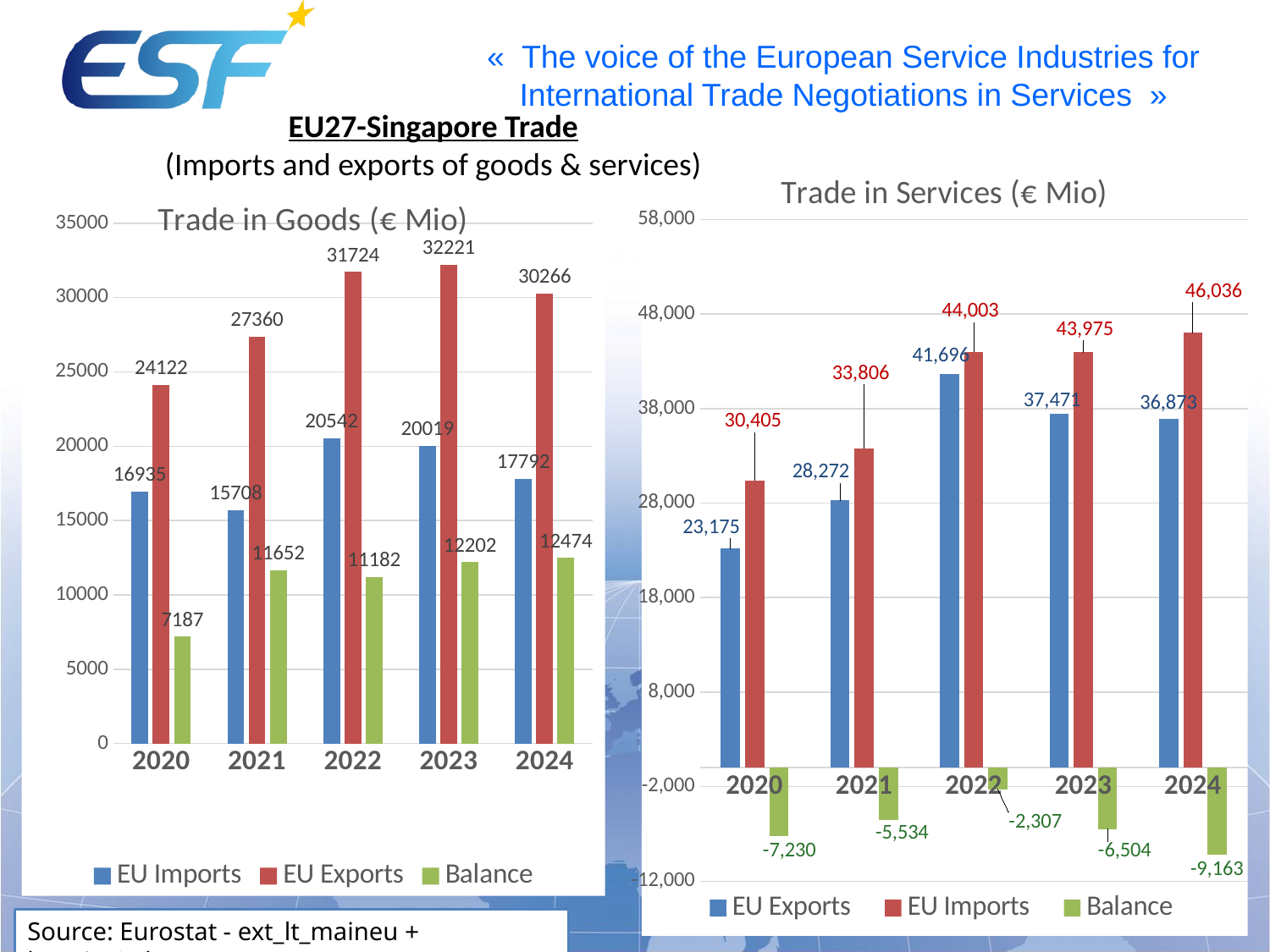
In the Trade in Services chart, what is the value of EU Imports in 2024? 46,036 How many series does the legend of the Trade in Services chart list? 3 In the Trade in Services chart, which year has the lowest Balance value? 2024 What type of chart is the Trade in Goods chart? bar chart In the Trade in Goods chart, which year has the lowest EU Exports value? 2020 In the Trade in Services chart, which year has the highest EU Exports value? 2022 In the Trade in Services chart, is EU Exports in 2021 larger or smaller than EU Imports in 2021? smaller In the Trade in Goods chart, which year has the highest EU Imports value? 2022 In the Trade in Goods chart, what is the value of EU Exports in 2023? 32221 In the Trade in Goods chart, what is the difference between EU Exports and EU Imports in 2024? 12474 In the Trade in Services chart, what is the Balance value for 2022? -2,307 In the Trade in Goods chart, what is the Balance value for 2020? 7187